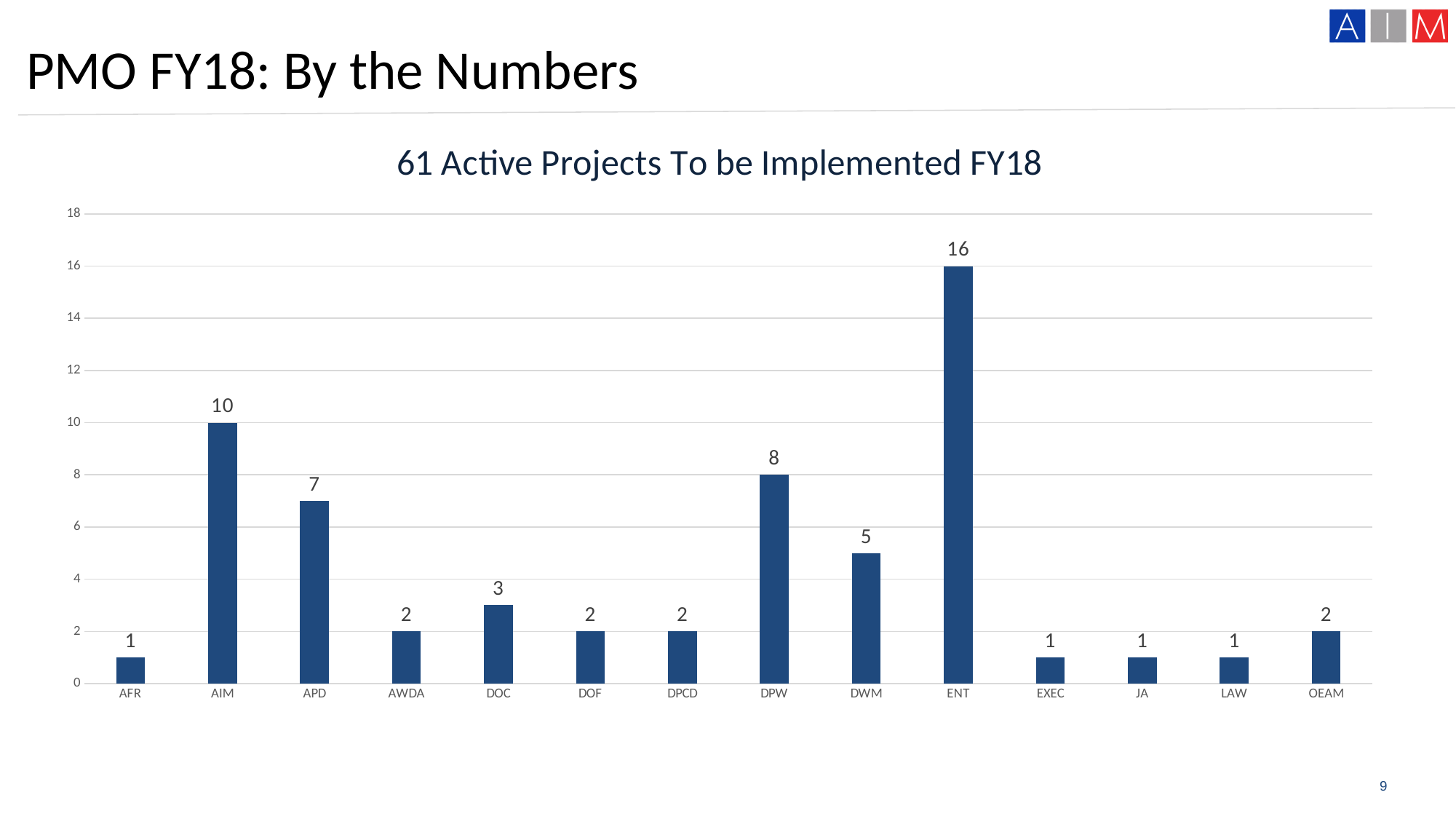
What is the value for ENT? 16 Which is larger, the value for AIM or the value for DPW? AIM What is the difference between the values for APD and DOC? 4 What is the value for DWM? 5 What kind of chart is shown on the slide? bar chart What is the title of the chart? 61 Active Projects To be Implemented FY18 What is the difference between the values for ENT and AIM? 6 Which category has the highest value? ENT What is the highest value shown on the y axis? 18 How many categories are shown on the x axis? 14 What is the value for DPW? 8 Is the value for ENT greater or less than 14? greater